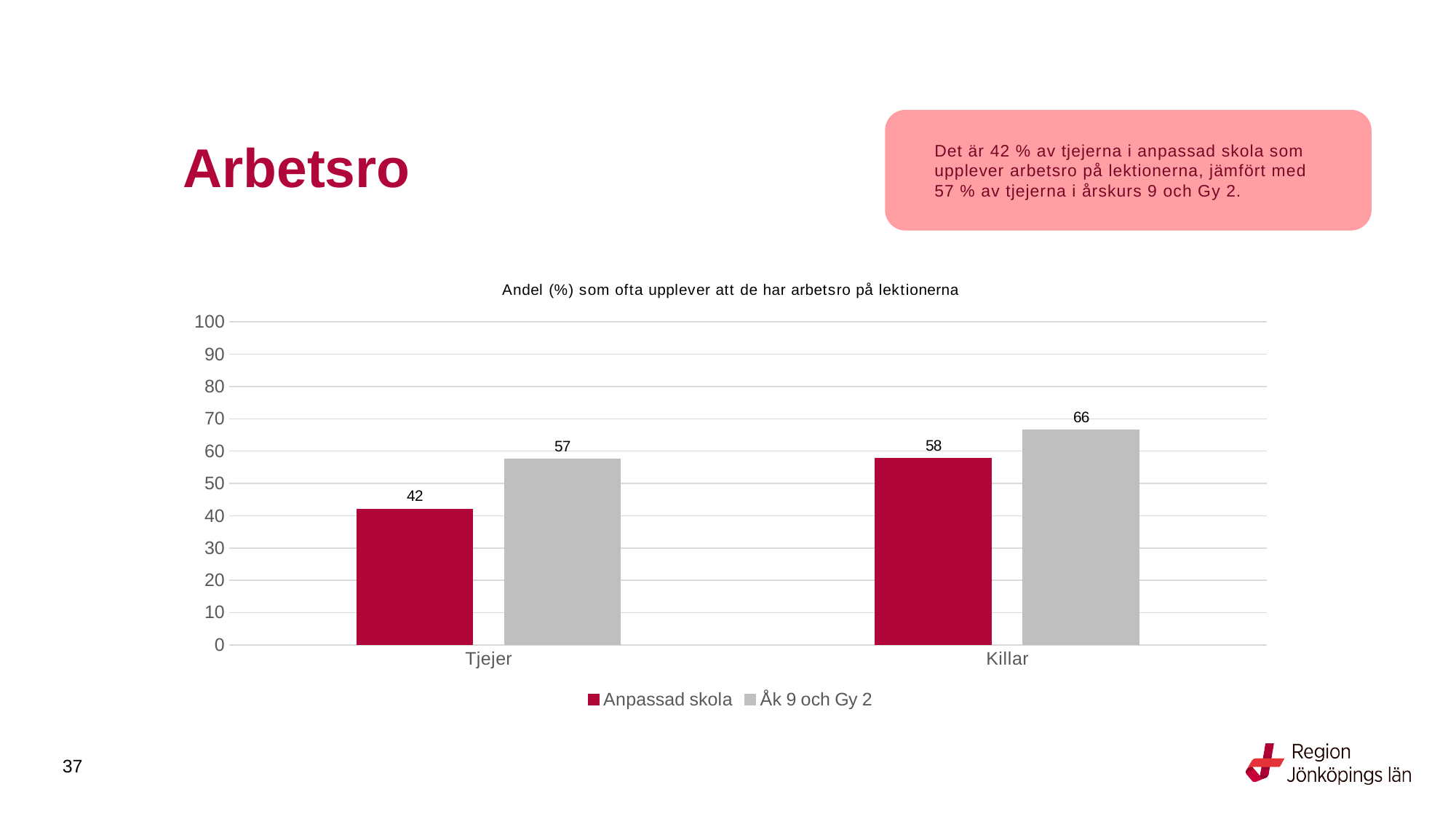
What is the value for Åk 9 och Gy 2 in the Killar category? 66 Which is larger: Anpassad skola for Killar or Åk 9 och Gy 2 for Tjejer? Anpassad skola for Killar What is the difference between Åk 9 och Gy 2 and Anpassad skola for Killar? 8 What kind of chart is shown on the slide? Bar chart Is the value for Åk 9 och Gy 2 in the Killar category greater or less than 60? greater What is the value for Anpassad skola in the Tjejer category? 42 What is the difference between Åk 9 och Gy 2 and Anpassad skola for Tjejer? 15 What is the value for Anpassad skola in the Killar category? 58 Which bar has the lowest value in the chart? Anpassad skola, Tjejer How many series does the legend list? 2 How many categories are shown on the x axis? 2 Which category has the highest value for the Åk 9 och Gy 2 series? Killar